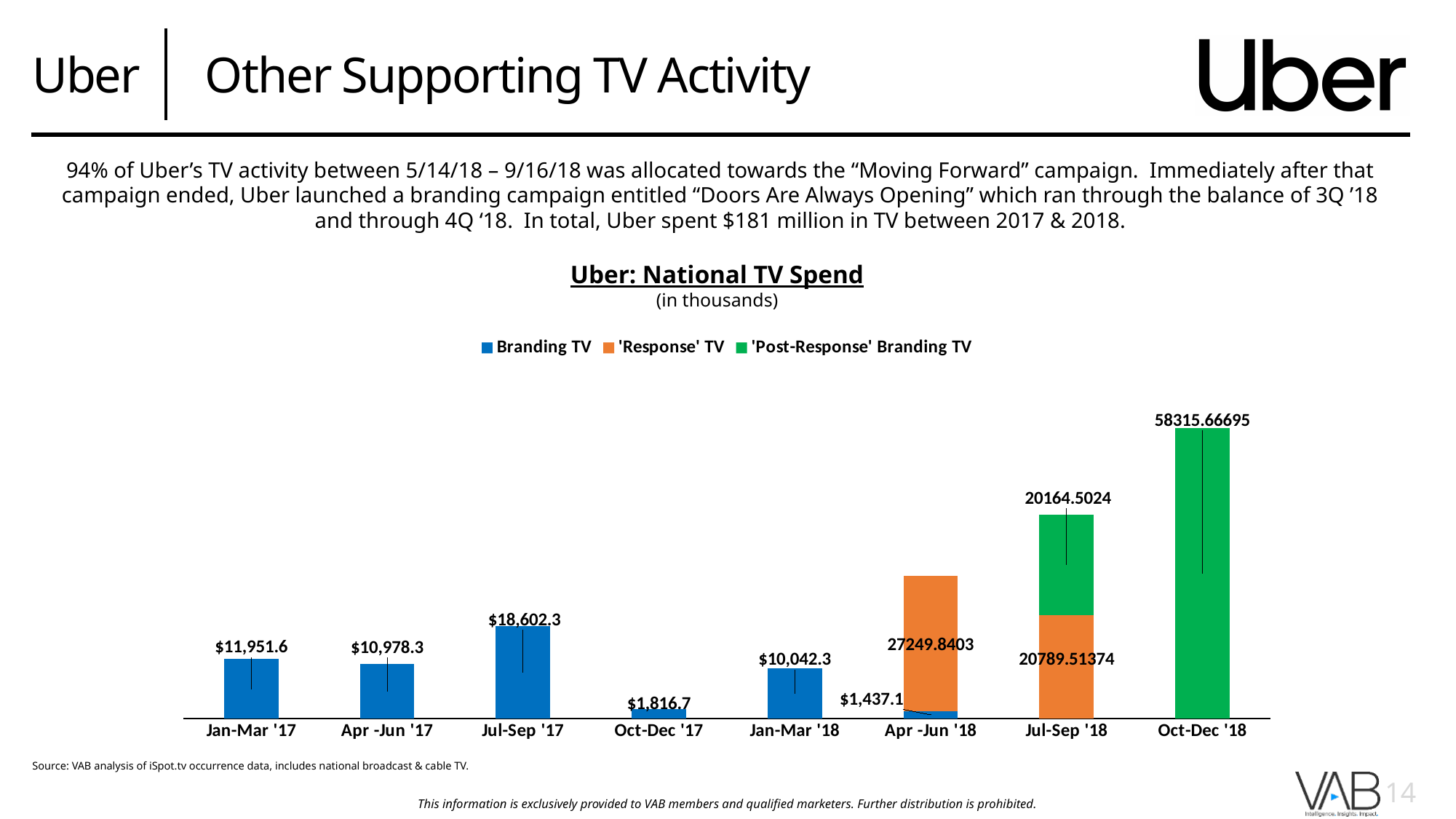
Which is larger: the Branding TV spend in Jul-Sep '17 or in Jan-Mar '18? Jul-Sep '17 Which quarter has the lowest Branding TV spend? Apr-Jun '18 Which quarter has the tallest bar overall? Oct-Dec '18 How many quarters are shown on the x axis? 8 How many series does the legend list? 3 What is the 'Response' TV spend for Apr-Jun '18? 27249.8403 What is the 'Post-Response' Branding TV spend for Oct-Dec '18? 58315.66695 What is the total spend for the Jul-Sep '18 bar? 40954.01614 What is the Branding TV spend for Jan-Mar '17? $11,951.6 What is the difference between the Branding TV spend in Jan-Mar '17 and Apr-Jun '17? $973.3 What is the Branding TV spend for Jul-Sep '17? $18,602.3 What kind of chart is shown? Stacked bar chart